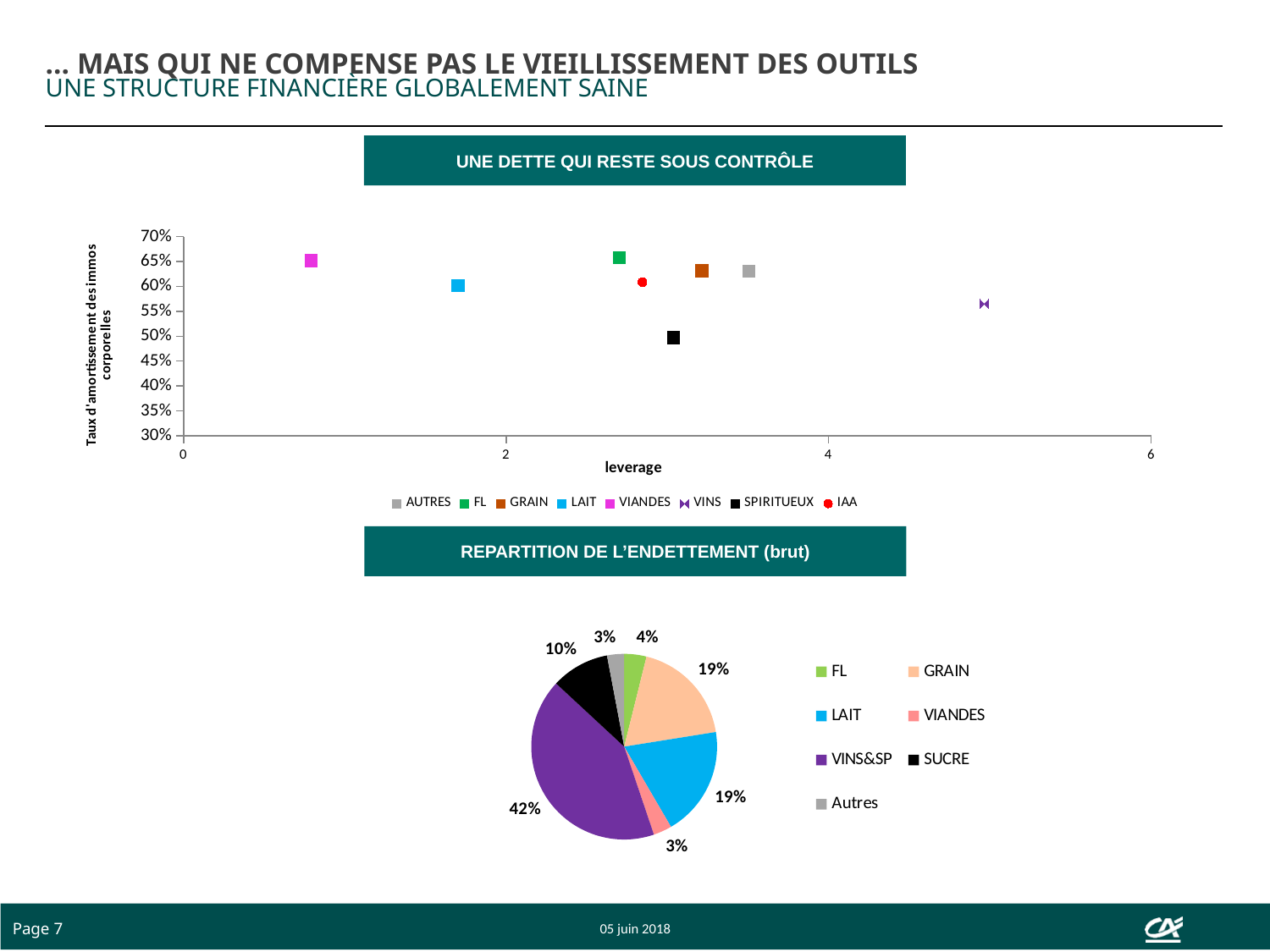
In the chart titled 'REPARTITION DE L'ENDETTEMENT (brut)', which category has the largest share? VINS&SP In the chart titled 'UNE DETTE QUI RESTE SOUS CONTRÔLE', which series has the highest leverage? VINS In the chart titled 'UNE DETTE QUI RESTE SOUS CONTRÔLE', which series has the lowest 'Taux d'amortissement des immos corporelles'? SPIRITUEUX In the chart titled 'REPARTITION DE L'ENDETTEMENT (brut)', what share of debt is attributed to VINS&SP? 42% In the chart titled 'REPARTITION DE L'ENDETTEMENT (brut)', what share of debt is attributed to SUCRE? 10% In the chart titled 'REPARTITION DE L'ENDETTEMENT (brut)', how many categories does the legend list? 7 What kind of chart is the one titled 'REPARTITION DE L'ENDETTEMENT (brut)'? Pie chart In the chart titled 'UNE DETTE QUI RESTE SOUS CONTRÔLE', which series has the lowest leverage? VIANDES In the chart titled 'REPARTITION DE L'ENDETTEMENT (brut)', what share of debt is attributed to GRAIN? 19% In the chart titled 'REPARTITION DE L'ENDETTEMENT (brut)', how many percentage points larger is the VINS&SP share than the SUCRE share? 32 percentage points In the chart titled 'UNE DETTE QUI RESTE SOUS CONTRÔLE', is the leverage for VINS greater or less than 4? greater In the chart titled 'UNE DETTE QUI RESTE SOUS CONTRÔLE', how many series does the legend list? 8